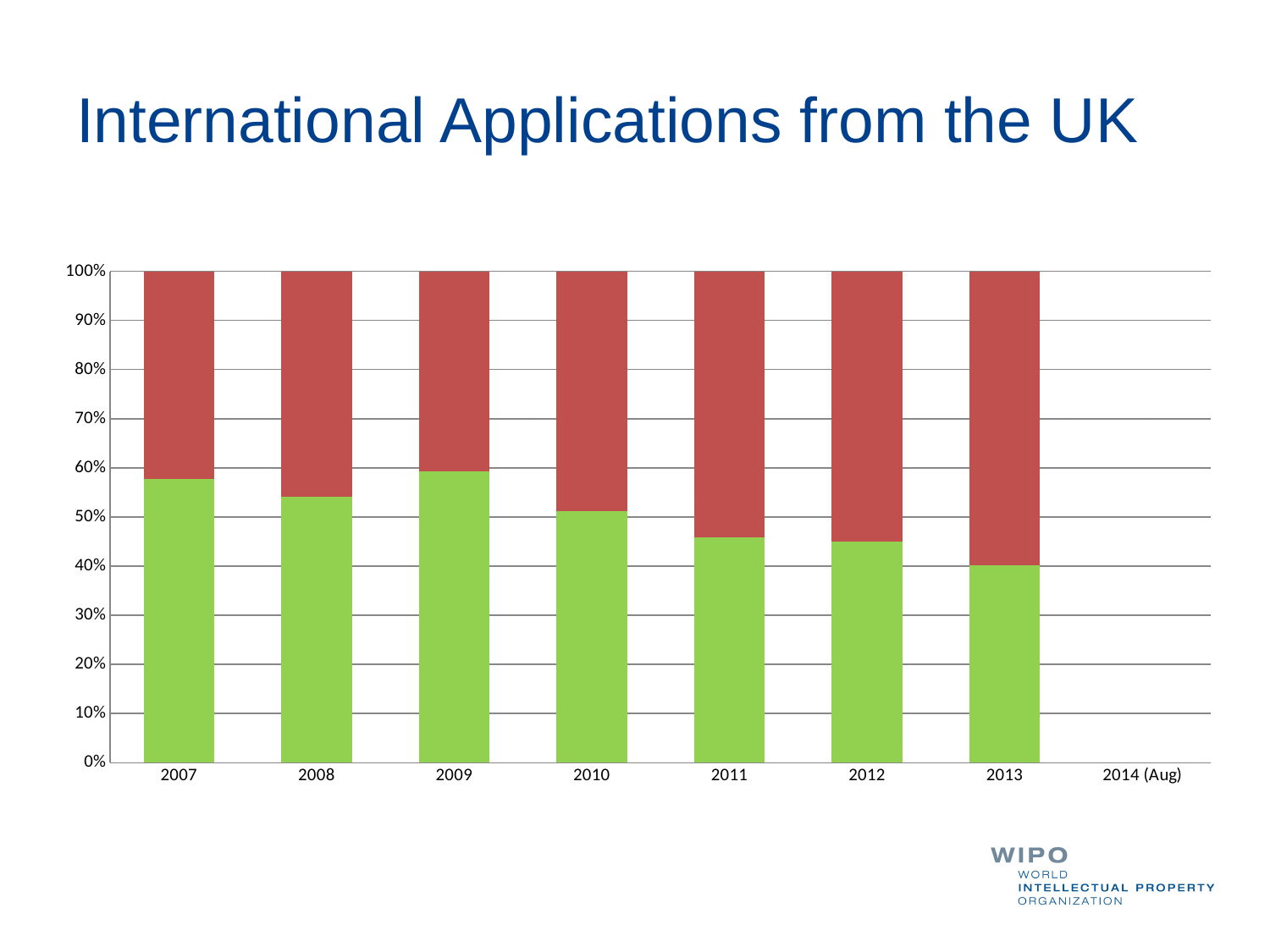
What kind of chart is shown on the slide? Stacked bar chart Is the green segment for 2013 greater or less than 50%? less What is the title of the chart on the slide? International Applications from the UK Which x-axis category has no bar plotted? 2014 (Aug) Is the green segment for 2007 greater or less than 50%? greater How many years have bars plotted in the chart? 7 Is the green segment for 2012 greater or less than 50%? less Does the green share rise or fall overall from 2007 to 2013? fall Which year has the smallest green segment? 2013 Is the green segment larger in 2007 or in 2013? 2007